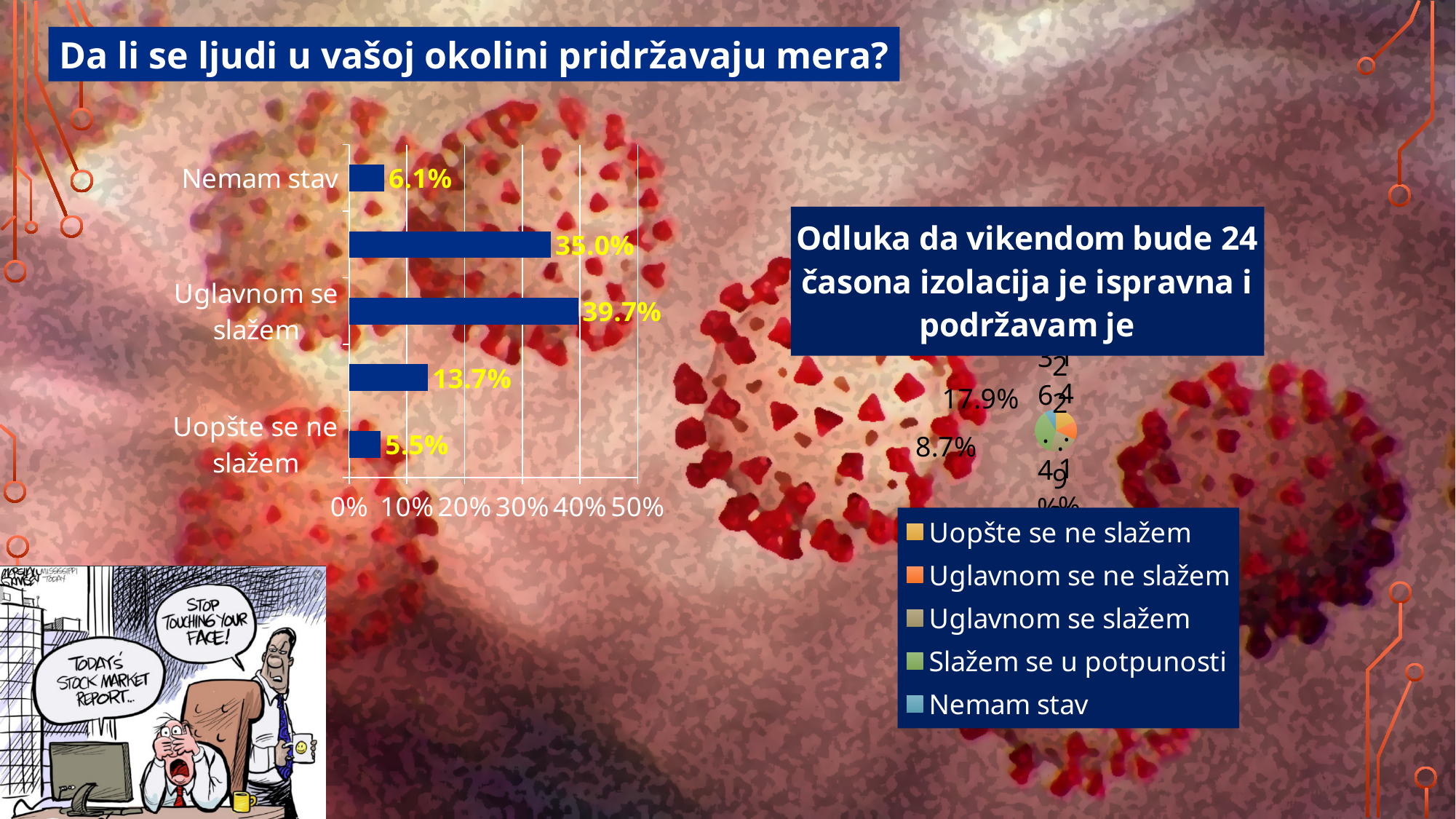
In the bar chart 'Da li se ljudi u vašoj okolini pridržavaju mera?', what is the difference between 'Uglavnom se slažem' and 'Nemam stav'? 33.6% What kind of chart is the chart on the left of the slide, titled 'Da li se ljudi u vašoj okolini pridržavaju mera?'? bar chart How many entries does the legend of the pie chart 'Odluka da vikendom bude 24 časona izolacija je ispravna i podržavam je' list? 5 In the bar chart 'Da li se ljudi u vašoj okolini pridržavaju mera?', is the value for 'Uglavnom se slažem' greater or less than 30%? greater In the bar chart 'Da li se ljudi u vašoj okolini pridržavaju mera?', which labelled category has the lowest value? Uopšte se ne slažem In the bar chart 'Da li se ljudi u vašoj okolini pridržavaju mera?', what is the value for 'Uglavnom se slažem'? 39.7% In the bar chart 'Da li se ljudi u vašoj okolini pridržavaju mera?', which is larger: 'Nemam stav' or 'Uopšte se ne slažem'? Nemam stav In the bar chart 'Da li se ljudi u vašoj okolini pridržavaju mera?', what is the value for 'Nemam stav'? 6.1% In the bar chart 'Da li se ljudi u vašoj okolini pridržavaju mera?', what is the difference between 'Nemam stav' and 'Uopšte se ne slažem'? 0.6% How many bars are plotted in the bar chart 'Da li se ljudi u vašoj okolini pridržavaju mera?'? 5 In the bar chart 'Da li se ljudi u vašoj okolini pridržavaju mera?', what is the value for 'Uopšte se ne slažem'? 5.5% In the bar chart 'Da li se ljudi u vašoj okolini pridržavaju mera?', which labelled category has the highest value? Uglavnom se slažem